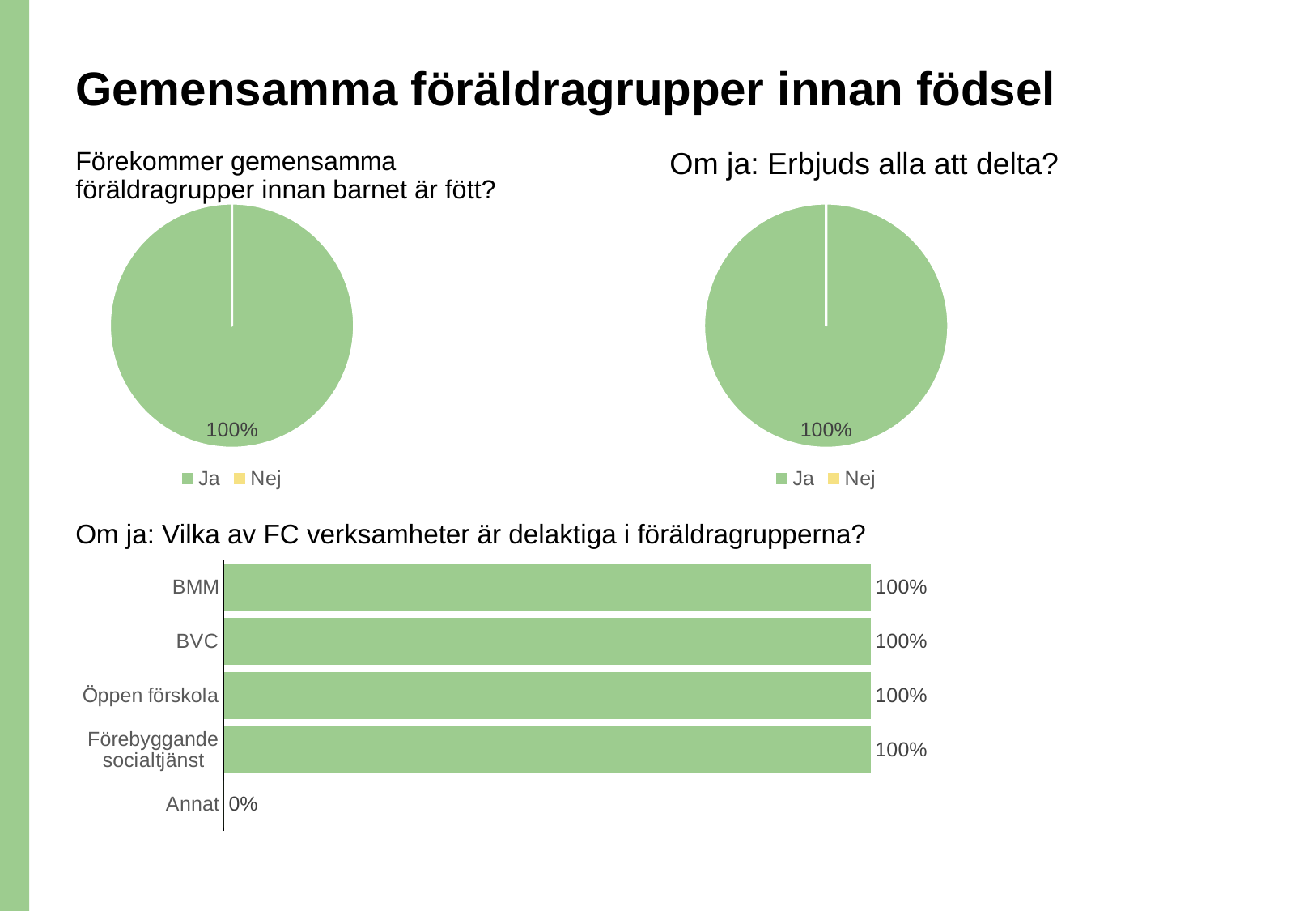
What kind of chart is the chart titled 'Om ja: Vilka av FC verksamheter är delaktiga i föräldragrupperna?'? Bar chart In the bar chart titled 'Om ja: Vilka av FC verksamheter är delaktiga i föräldragrupperna?', what is the value for BVC? 100% What kind of chart is the chart titled 'Om ja: Erbjuds alla att delta?'? Pie chart In the bar chart titled 'Om ja: Vilka av FC verksamheter är delaktiga i föräldragrupperna?', which category has the lowest value? Annat In the bar chart titled 'Om ja: Vilka av FC verksamheter är delaktiga i föräldragrupperna?', what is the difference between the values for BMM and Annat? 100% In the pie chart titled 'Om ja: Erbjuds alla att delta?', what share does 'Ja' have? 100% In the bar chart titled 'Om ja: Vilka av FC verksamheter är delaktiga i föräldragrupperna?', what is the value for Förebyggande socialtjänst? 100% In the bar chart titled 'Om ja: Vilka av FC verksamheter är delaktiga i föräldragrupperna?', what is the value for Annat? 0% In the pie chart titled 'Förekommer gemensamma föräldragrupper innan barnet är fött?', what share does 'Ja' have? 100% In the bar chart titled 'Om ja: Vilka av FC verksamheter är delaktiga i föräldragrupperna?', which is larger, the value for Öppen förskola or the value for Annat? Öppen förskola In the bar chart titled 'Om ja: Vilka av FC verksamheter är delaktiga i föräldragrupperna?', how many categories are shown? 5 How many entries does the legend of the pie chart titled 'Förekommer gemensamma föräldragrupper innan barnet är fött?' list? 2